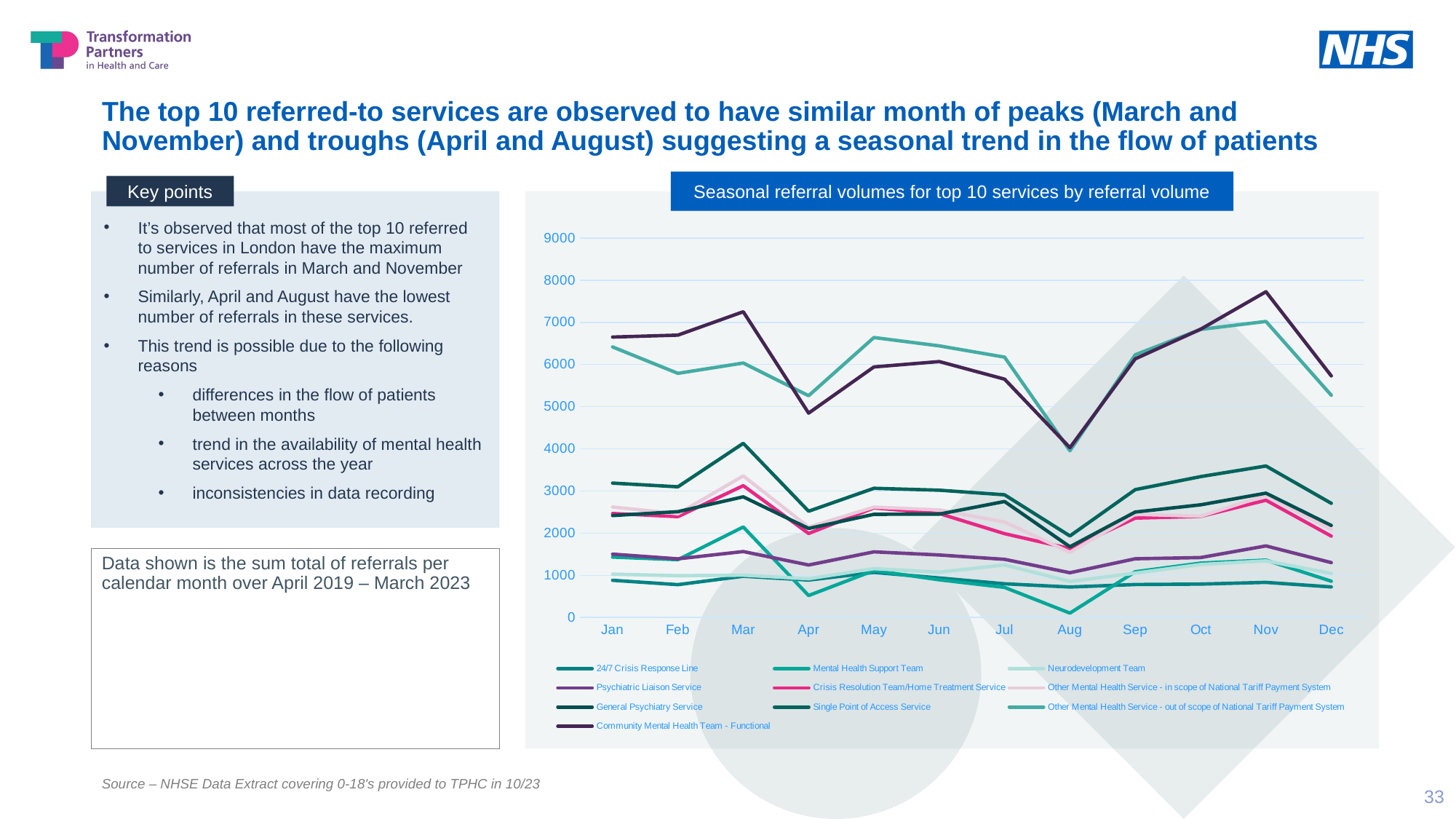
In which month does the Community Mental Health Team - Functional line reach its highest value? Nov Is the value for Mental Health Support Team in Aug greater or less than 1000? less Is the value for Other Mental Health Service - out of scope of National Tariff Payment System in May greater or less than 6000? greater Does the Community Mental Health Team - Functional line rise or fall from Aug to Nov? Rise What is the title of the chart? Seasonal referral volumes for top 10 services by referral volume Is the value for Community Mental Health Team - Functional in Nov greater or less than 7000? greater How many months are shown along the x axis of the chart? 12 In which month does the Mental Health Support Team line reach its lowest value? Aug In May, which is larger: Other Mental Health Service - out of scope of National Tariff Payment System or Community Mental Health Team - Functional? Other Mental Health Service - out of scope of National Tariff Payment System How many services does the chart's legend list? 10 What kind of chart is shown on the slide? Line chart Which service has the highest referral volume in Nov? Community Mental Health Team - Functional